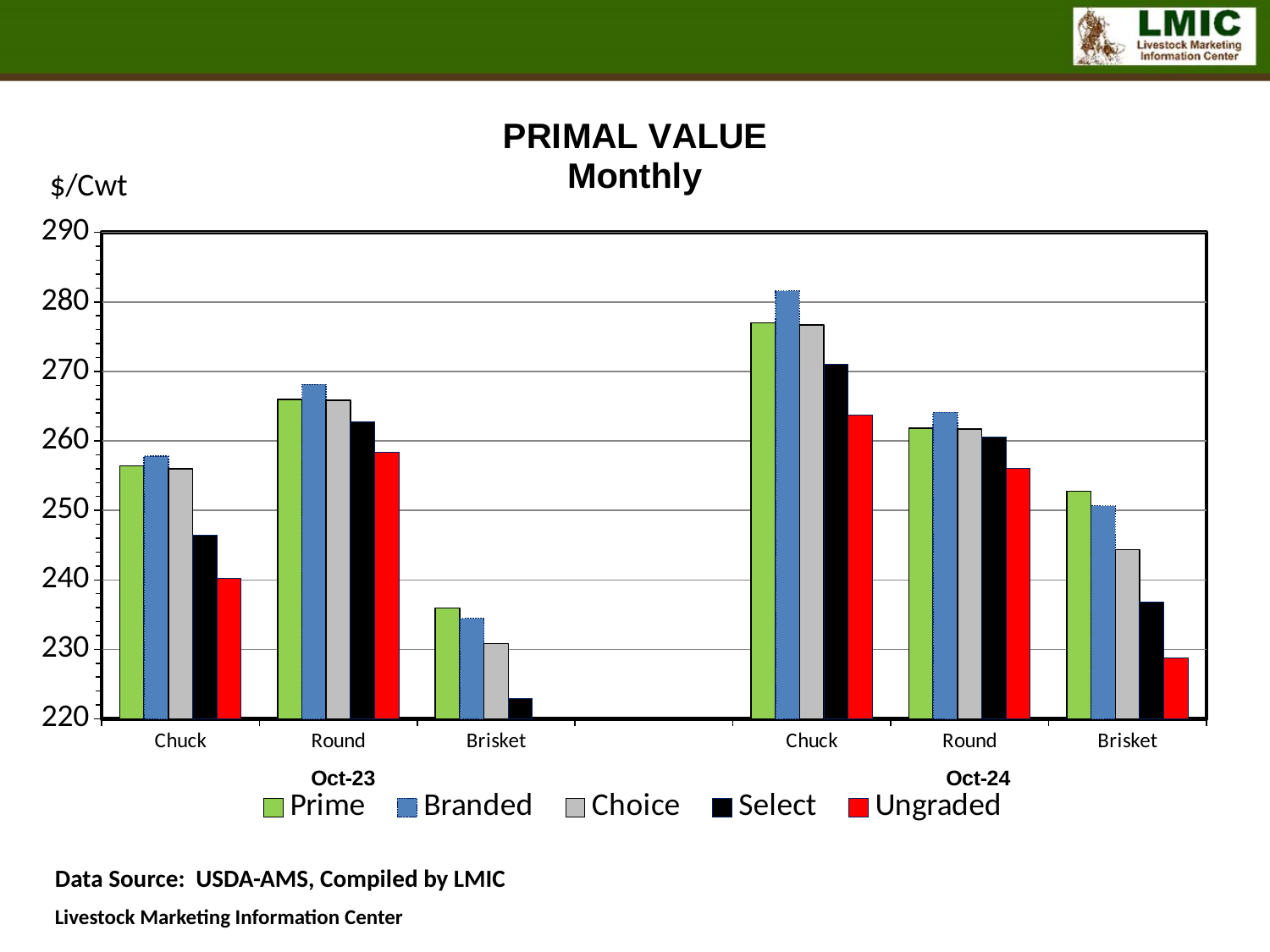
How many primal cuts are shown for each month (Oct-23 and Oct-24)? 3 How many series does the legend list? 5 Is the Ungraded value for Chuck in Oct-24 greater or less than 260? greater For Brisket in Oct-24, do the bars rise or fall going from Prime to Ungraded? fall Which is larger, the Select value for Chuck in Oct-23 or the Select value for Chuck in Oct-24? Oct-24 Is the Ungraded value for Chuck in Oct-23 greater or less than 250? less What unit is shown on the y axis? $/Cwt Which cut and month has the tallest bar on the whole chart? Chuck, Oct-24 Is the Select value for Brisket in Oct-23 greater or less than 230? less What kind of chart is shown on the slide? Bar chart Which series has the lowest bar for Brisket in Oct-24? Ungraded Which series has the tallest bar for Chuck in Oct-24? Branded